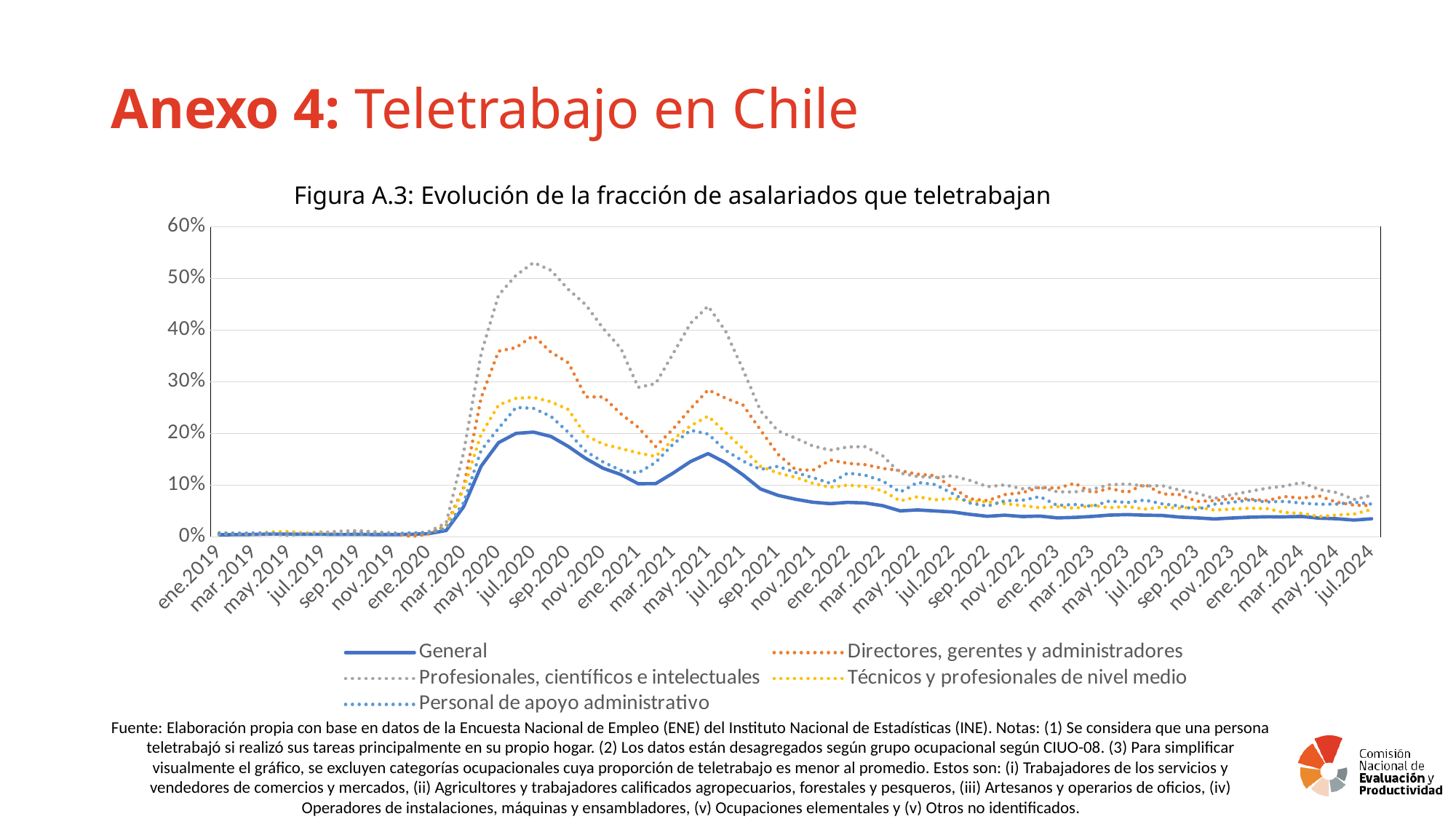
Which series reaches the highest value at any point in Figura A.3? Profesionales, científicos e intelectuales Is the peak value of the Profesionales, científicos e intelectuales series greater or less than 50%? greater Does the General series rise or fall between ene.2020 and jul.2020? rise Is the peak value of the Directores, gerentes y administradores series greater or less than 30%? greater Is the value of the General series in jul.2024 greater or less than 10%? less Which series has the lowest value in jul.2020? General How many series does the legend of Figura A.3 list? 5 In jul.2020, which series has a higher value: Directores, gerentes y administradores or Técnicos y profesionales de nivel medio? Directores, gerentes y administradores Which series is drawn as a solid line in Figura A.3? General Does the General series rise or fall overall between jul.2020 and jul.2024? fall What kind of chart is shown in Figura A.3? line chart